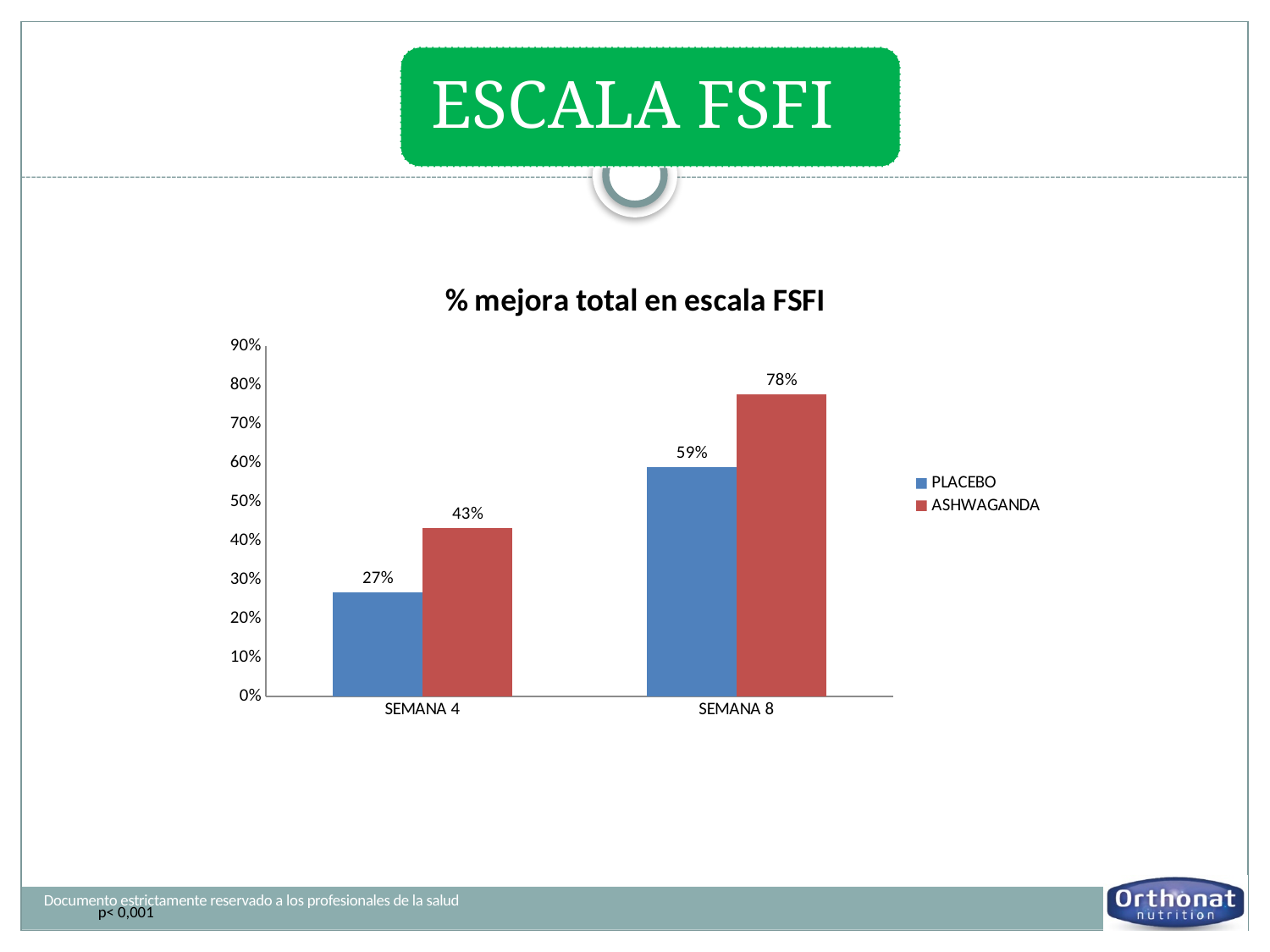
What kind of chart is shown on the slide? Bar chart What is the title of the chart? % mejora total en escala FSFI What is the difference between ASHWAGANDA and PLACEBO at SEMANA 8? 19% What is the value for PLACEBO at SEMANA 8? 59% What is the value for ASHWAGANDA at SEMANA 4? 43% What is the value for PLACEBO at SEMANA 4? 27% How many categories are shown on the x axis? 2 What is the value for ASHWAGANDA at SEMANA 8? 78% How many series does the legend list? 2 Which bar has the highest value on the chart? ASHWAGANDA at SEMANA 8 Which is larger at SEMANA 4, PLACEBO or ASHWAGANDA? ASHWAGANDA Which bar has the lowest value on the chart? PLACEBO at SEMANA 4